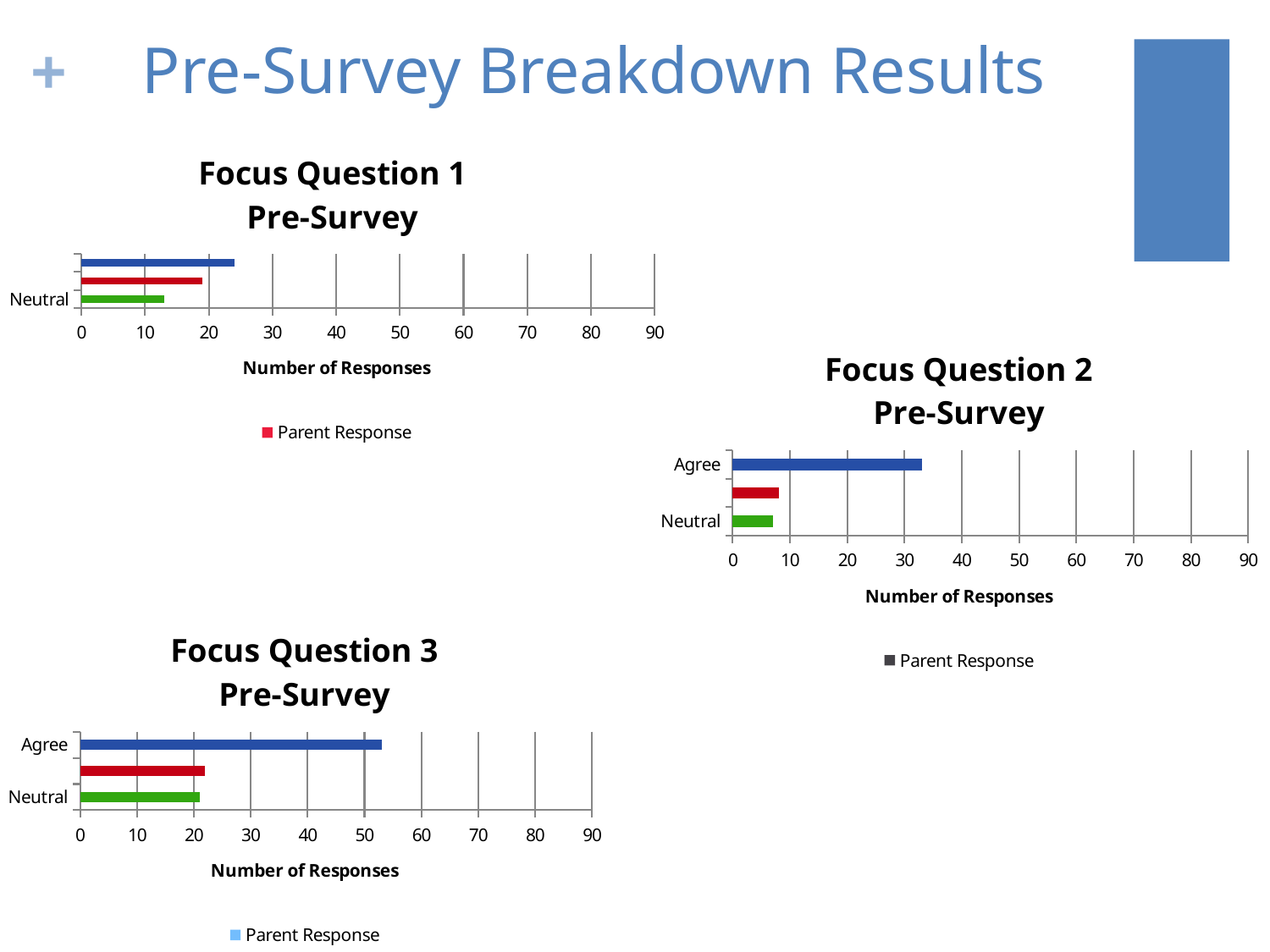
In the Focus Question 2 Pre-Survey chart, is the value for Agree greater or less than 30? greater In the Focus Question 3 Pre-Survey chart, is the value for Neutral greater or less than 30? less In the Focus Question 3 Pre-Survey chart, which is larger, Agree or Neutral? Agree In the Focus Question 1 Pre-Survey chart, is the value for Neutral greater or less than 20? less In the Focus Question 2 Pre-Survey chart, which is larger, Agree or Neutral? Agree What entry does the legend of the Focus Question 2 Pre-Survey chart list? Parent Response What is the x-axis title of the Focus Question 1 Pre-Survey chart? Number of Responses How many bars are plotted in the Focus Question 3 Pre-Survey chart? 3 What kind of chart is the Focus Question 2 Pre-Survey chart? bar chart In the Focus Question 3 Pre-Survey chart, which category has the highest value? Agree